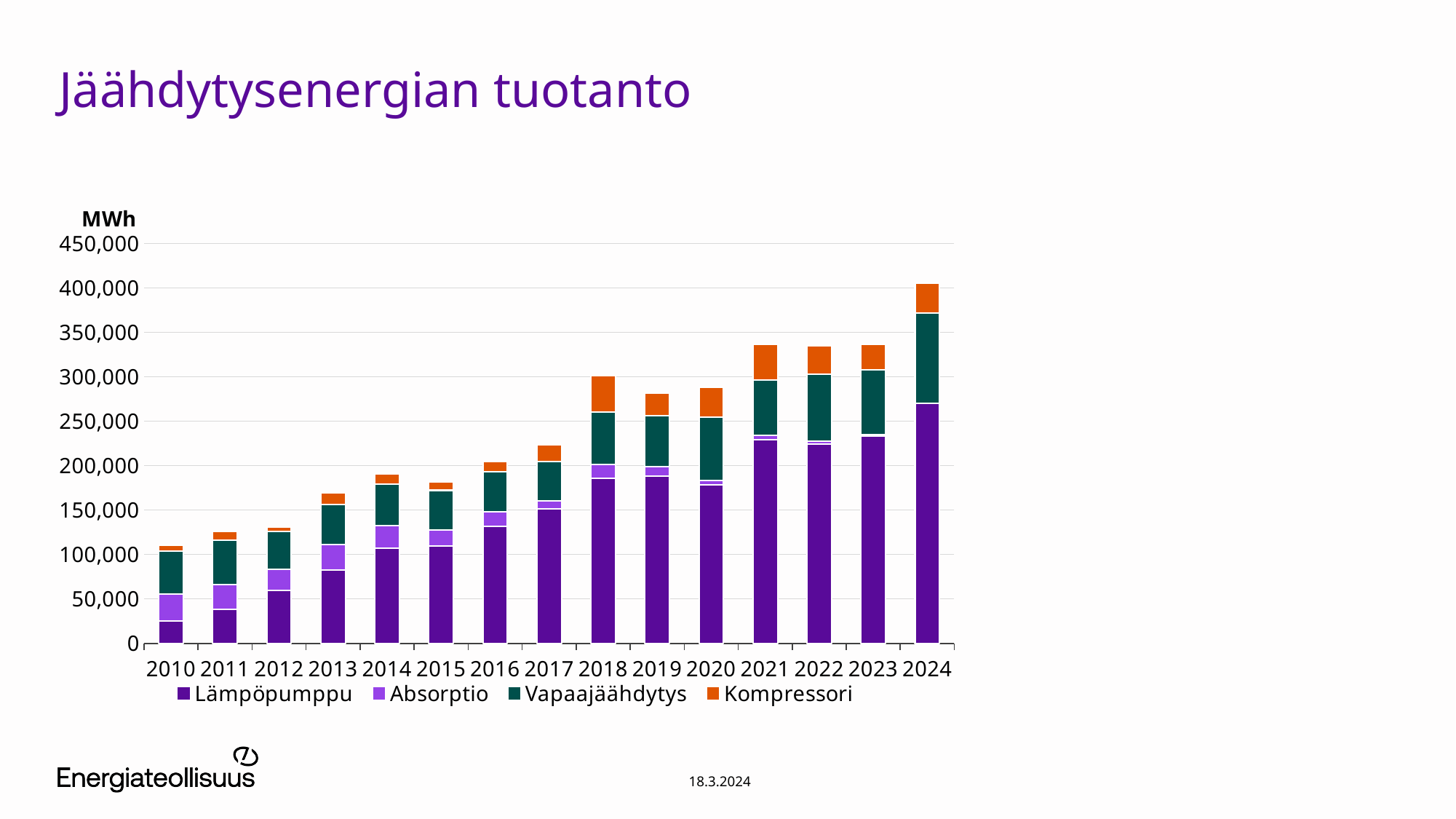
Is the total for 2010 greater or less than 150,000? less What kind of chart is shown on the slide? Stacked bar chart Is the total for 2018 greater or less than 250,000? greater How many series does the legend list? 4 Do the total values generally rise or fall from 2010 to 2024? rise How many years are shown on the x axis of the chart? 15 What unit is shown on the y axis of the chart? MWh Is the Lämpöpumppu value for 2024 greater or less than 250,000? greater Which year has the larger total, 2019 or 2021? 2021 Which year has the highest total cooling energy production? 2024 Which year has the lowest total cooling energy production? 2010